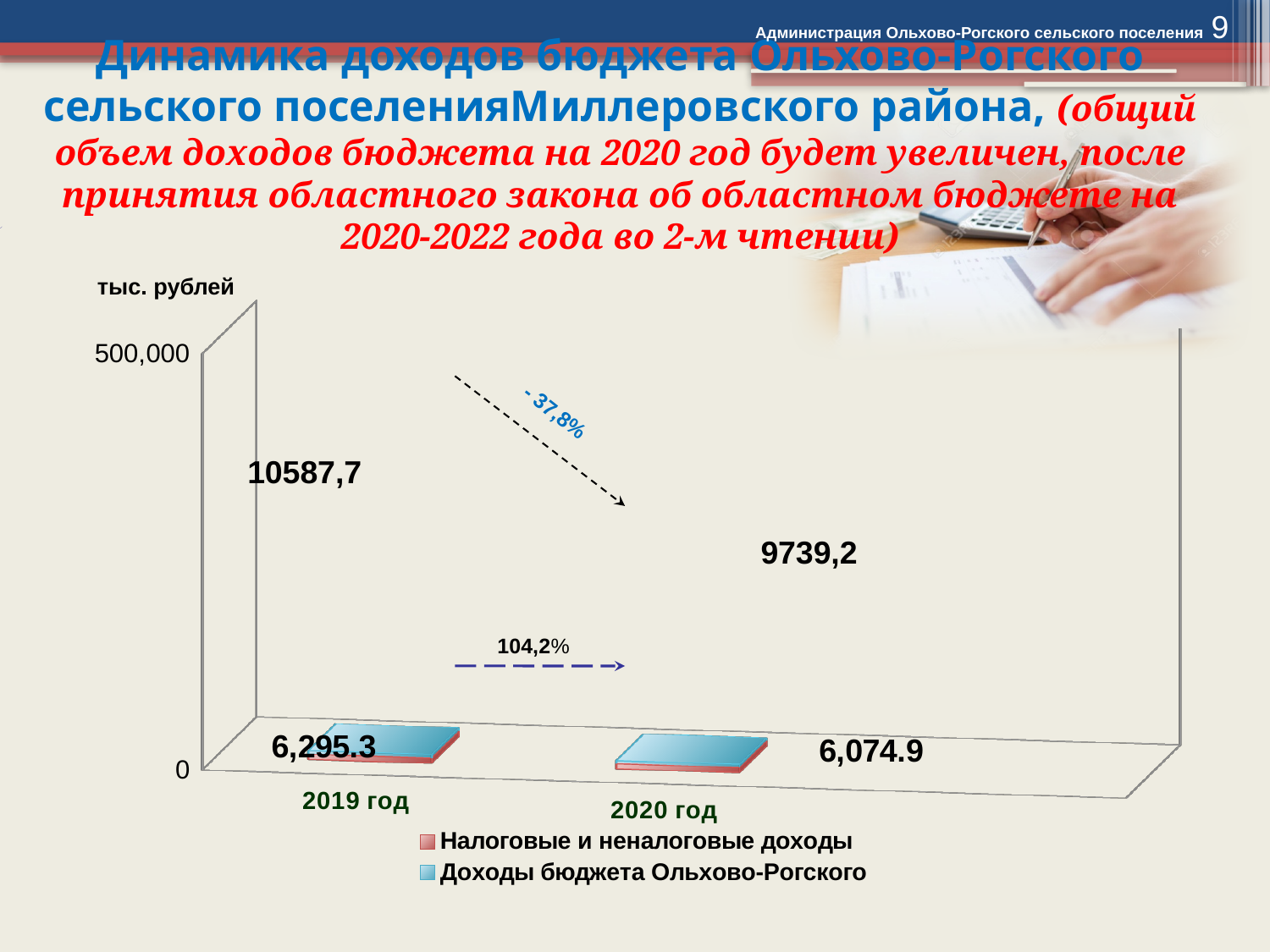
What value is printed next to the bar for 2019 год? 6,295.3 How many series does the chart legend list? 2 What are the two legend entries of the chart? Налоговые и неналоговые доходы; Доходы бюджета Ольхово-Рогского Which year has the larger bar value printed next to it, 2019 год or 2020 год? 2019 год What unit label is printed above the vertical axis of the chart? тыс. рублей What percentage is printed above the horizontal dashed arrow between the two years? 104,2% How many categories (years) are shown on the x axis of the chart? 2 What kind of chart is shown on the slide? bar chart What percentage is printed on the downward dashed arrow between the two years? - 37,8% What is the difference between the two large values printed in the chart area, 10587,7 and 9739,2? 848,5 What value is printed next to the bar for 2020 год? 6,074.9 What is the difference between the bar values printed for 2019 год (6,295.3) and 2020 год (6,074.9)? 220.4